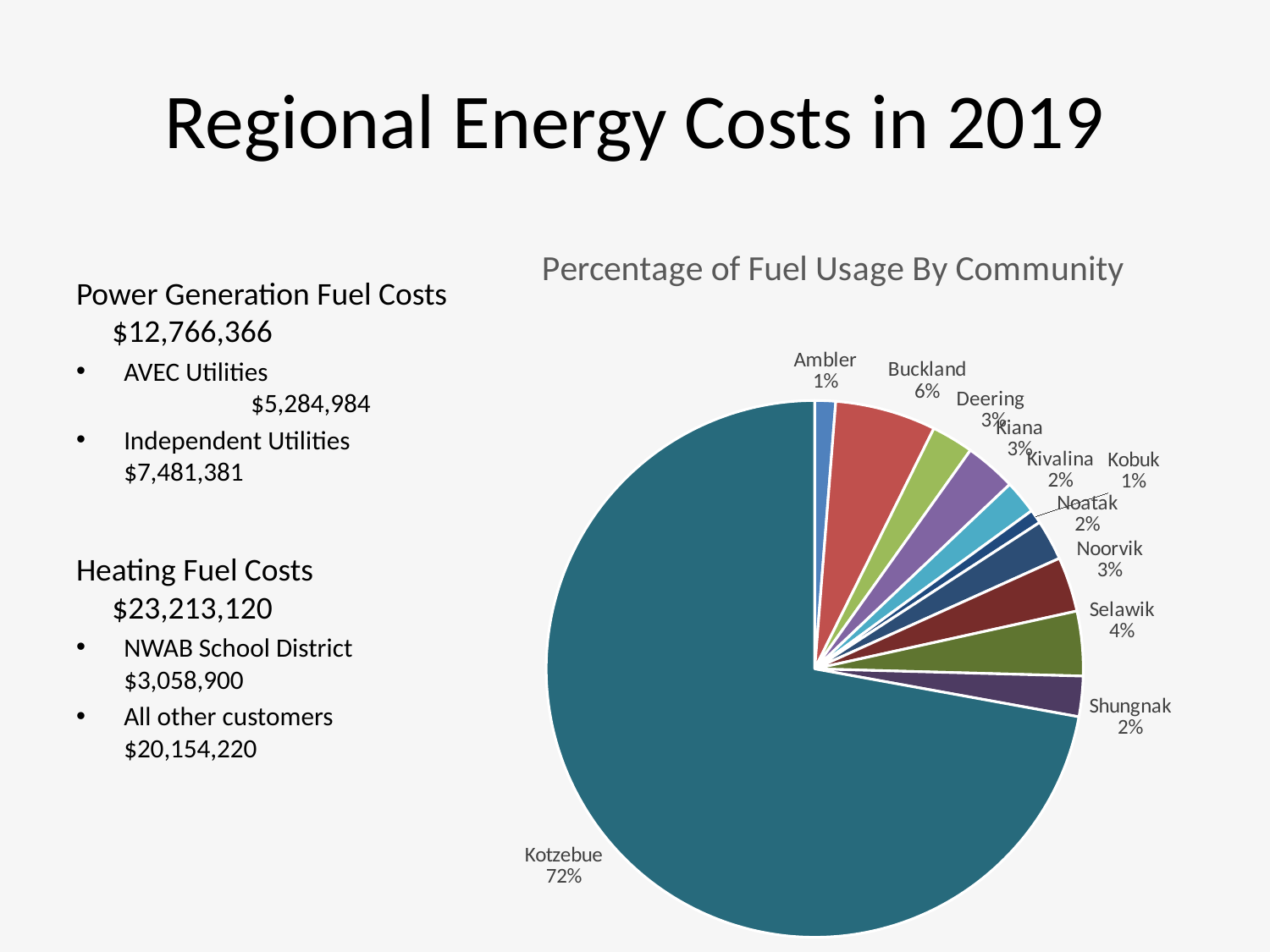
What percentage of fuel usage is attributed to Buckland? 6% What is the difference in percentage points between Kotzebue's share and Buckland's share? 66 What is the title of the chart? Percentage of Fuel Usage By Community Which has a larger share of fuel usage, Buckland or Deering? Buckland Which community has the largest share of fuel usage? Kotzebue Which has a larger share of fuel usage, Selawik or Shungnak? Selawik What percentage of fuel usage is attributed to Kotzebue? 72% What percentage of fuel usage is attributed to Selawik? 4% How many communities are shown in the pie chart? 11 What type of chart is shown on the slide? pie chart What share of the pie does Kivalina represent? 2% What percentage of fuel usage is attributed to Noorvik? 3%